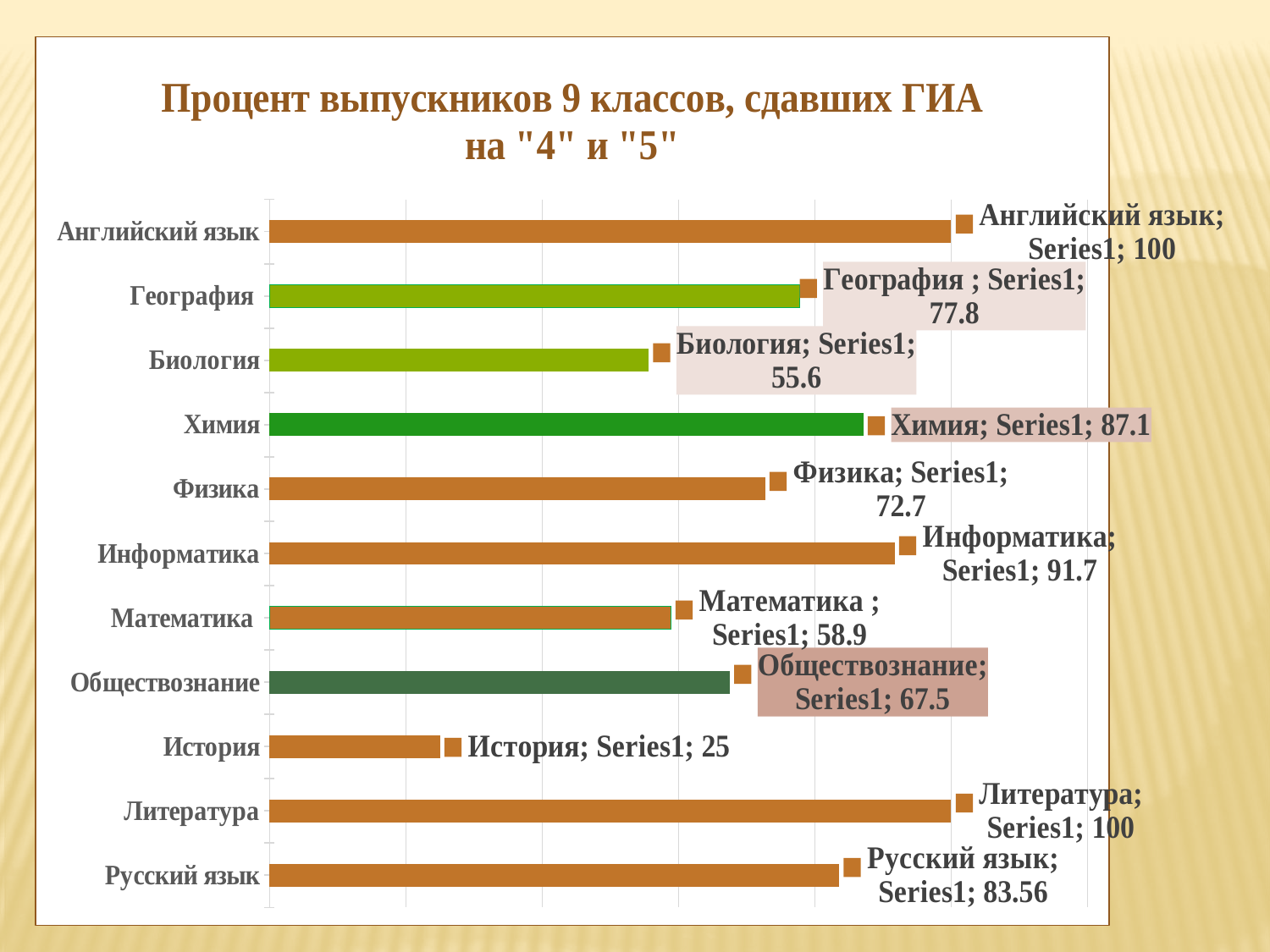
What is the value for Химия? 87.1 What is the difference between the values for География and Физика? 5.1 Which is larger, the value for Обществознание or the value for Биология? Обществознание What kind of chart is shown on the slide? Bar chart What is the title of the chart? Процент выпускников 9 классов, сдавших ГИА на "4" и "5" What is the value for Информатика? 91.7 Which category has the lowest value? История What is the value for Биология? 55.6 What is the difference between the values for Математика and История? 33.9 How many categories are shown in the chart? 11 What is the value for Русский язык? 83.56 Which is larger, the value for Физика or the value for Химия? Химия